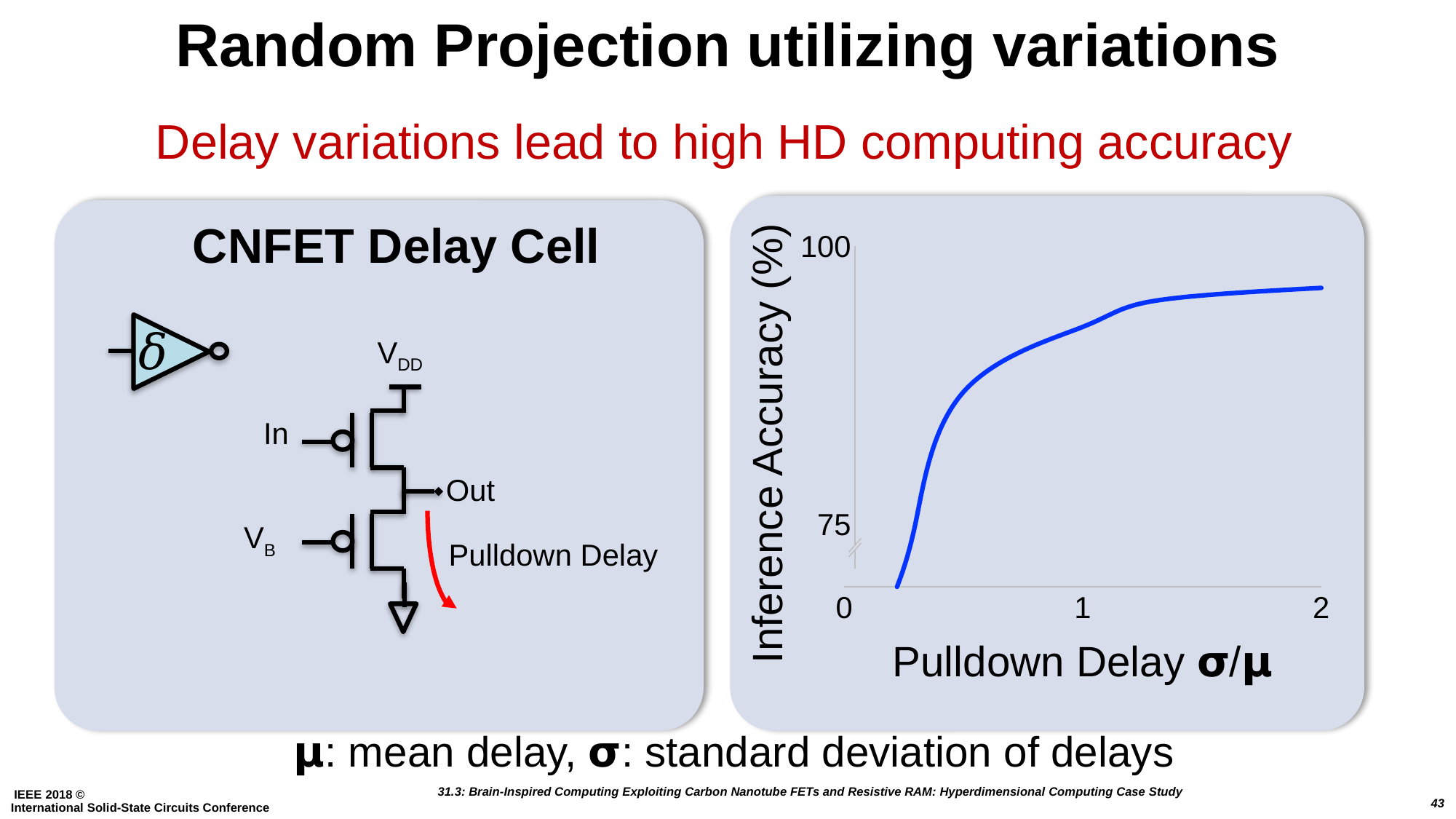
What is the label of the y-axis in the chart on the right? Inference Accuracy (%) In the chart on the right, which has the higher inference accuracy: Pulldown Delay σ/μ = 1 or σ/μ = 2? σ/μ = 2 What kind of chart is shown on the right side of the slide? line chart In the chart on the right, is the inference accuracy at Pulldown Delay σ/μ = 2 greater or less than 100? less In the chart on the right, is the inference accuracy at Pulldown Delay σ/μ = 1 greater or less than 75? greater In the chart on the right, does inference accuracy rise or fall as Pulldown Delay σ/μ increases? rise What is the highest tick value shown on the y-axis of the chart on the right? 100 In the chart on the right, is the inference accuracy at the leftmost point of the curve greater or less than 75? less What is the largest tick value shown on the x-axis of the chart on the right? 2 How many lines are plotted in the chart on the right? 1 What is the label of the x-axis in the chart on the right? Pulldown Delay σ/μ